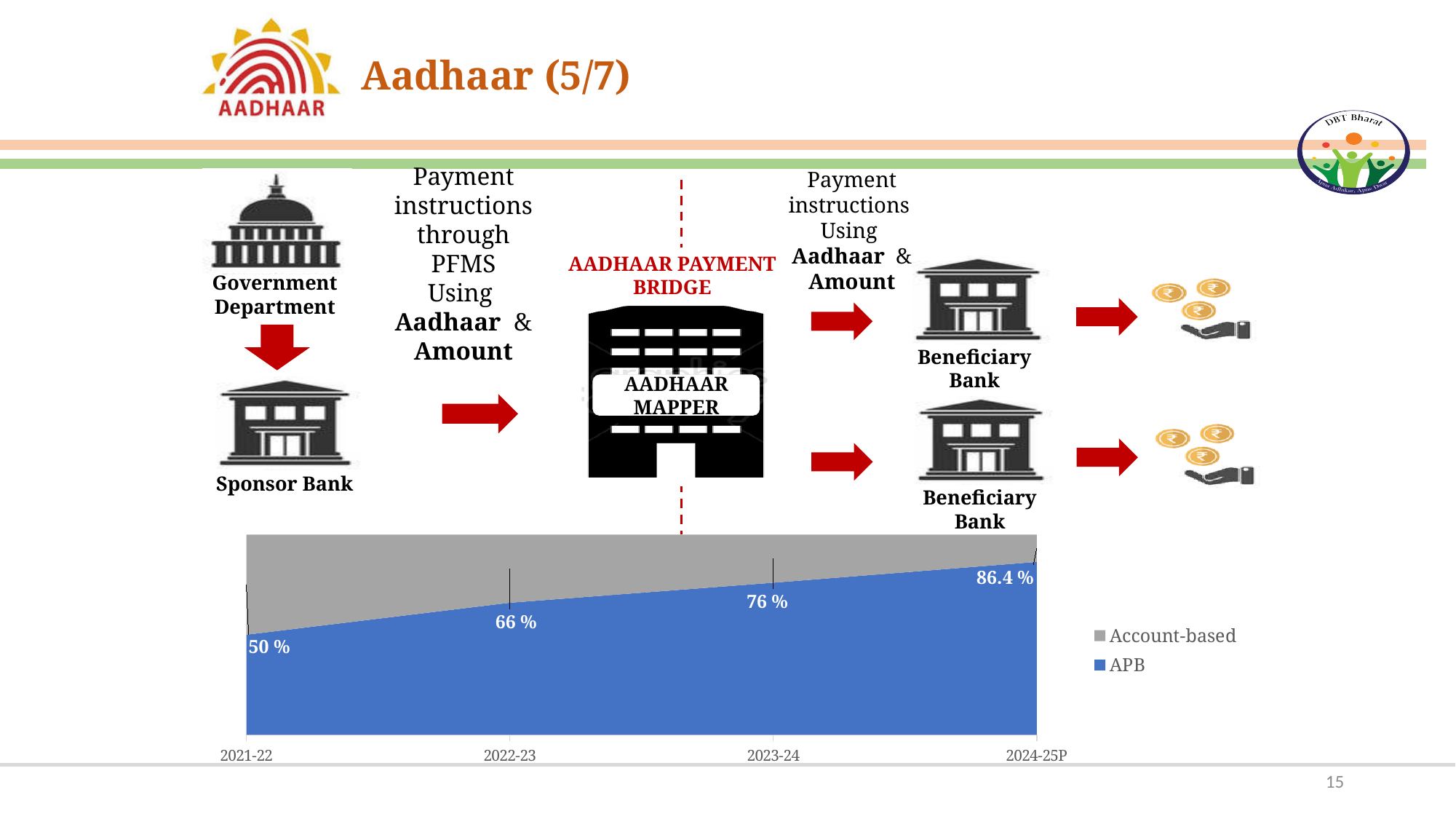
Does the APB share rise or fall from 2021-22 to 2024-25P? Rise How many series does the chart legend list? 2 What is the APB value for 2022-23? 66 % What kind of chart is shown at the bottom of the slide? Area chart In which year is the APB share highest? 2024-25P Which is larger, the APB value for 2022-23 or for 2023-24? 2023-24 What is the APB value for 2021-22? 50 % What is the difference between the APB value for 2023-24 and 2022-23? 10 % What is the APB value for 2023-24? 76 % What is the APB value for 2024-25P? 86.4 % In which year is the APB share lowest? 2021-22 How many years are shown on the x axis of the chart? 4